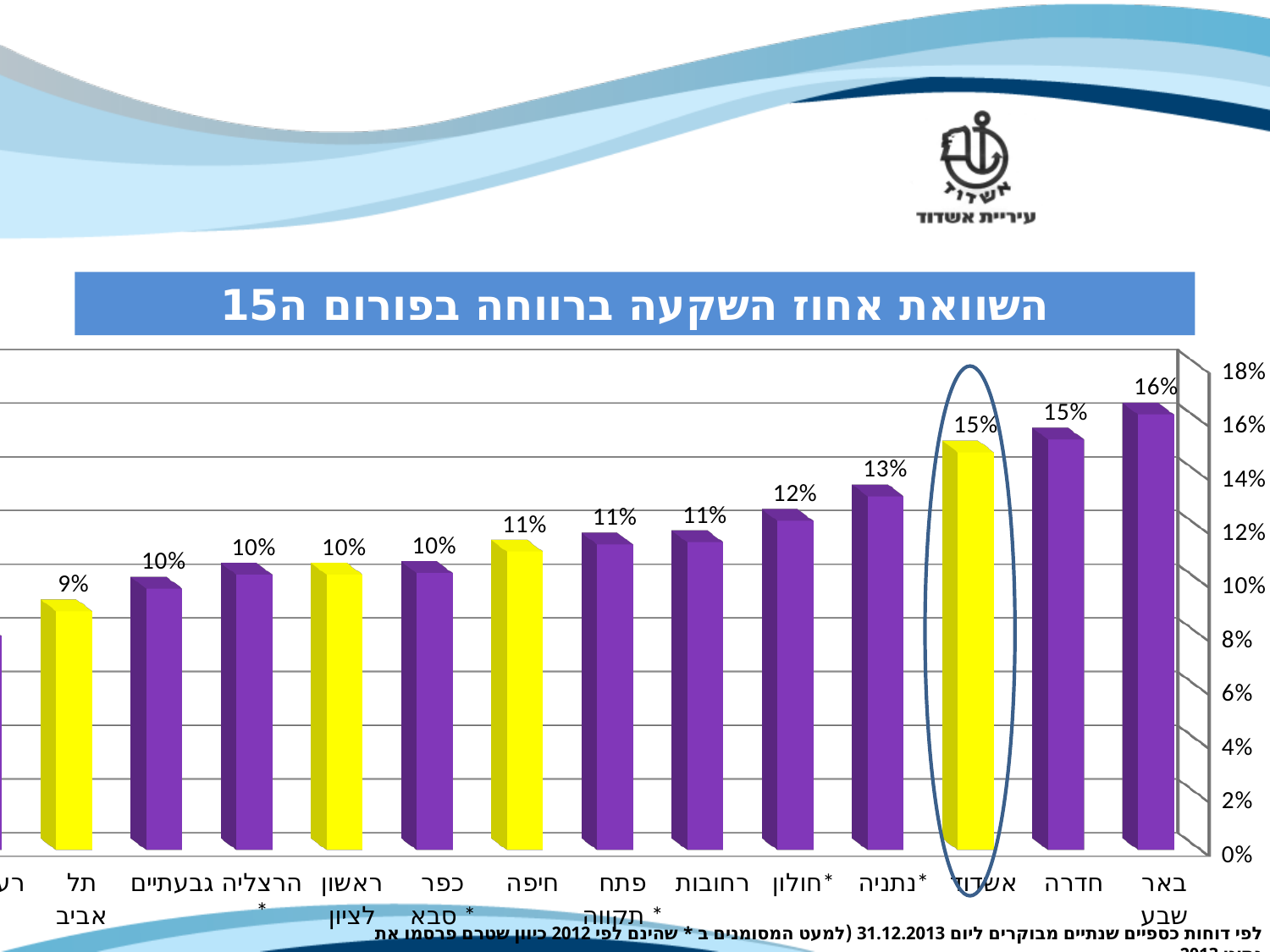
What is the value for נתניה? 13% Which city's bar is circled on the chart? אשדוד Do the values rise or fall moving from left to right along the x axis? rise Which city has the highest value in the chart? באר שבע What is the difference between the values for אשדוד and חולון? 3% What is the value for אשדוד? 15% What is the value for חולון? 12% What is the difference between the values for באר שבע and תל אביב? 7% What is the value for באר שבע? 16% What kind of chart is shown on the slide? bar chart What is the value for תל אביב? 9% Which is larger, the value for חדרה or the value for נתניה? חדרה